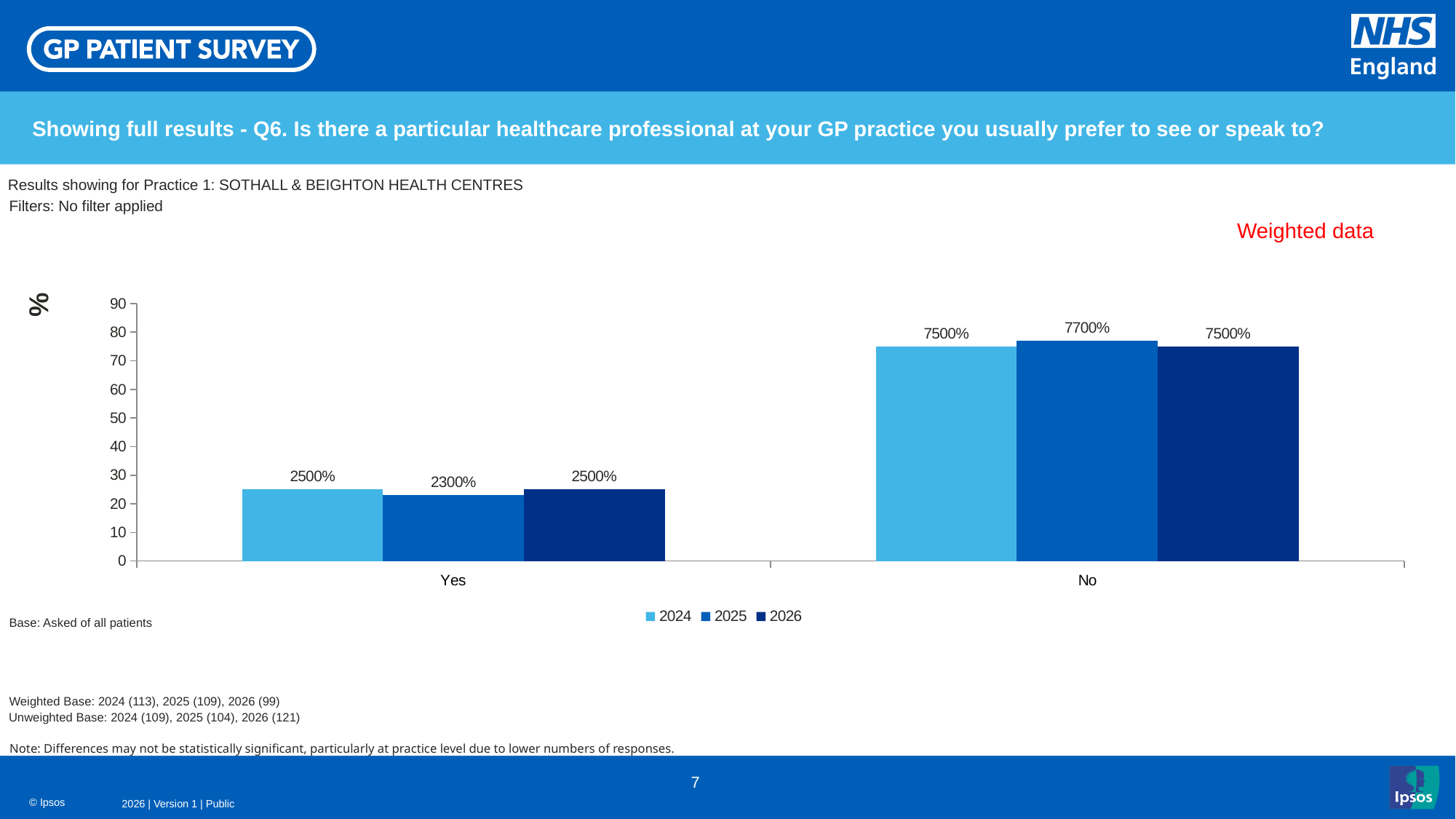
Is the 2025 bar for Yes greater or less than 30 on the axis? less Which year has the highest bar in the No category? 2025 Is the 2024 bar for No greater or less than 70 on the axis? greater What is the data label for 2024 in the Yes category? 2500% Which is larger: the 2026 bar for Yes or the 2026 bar for No? No What is the data label for 2025 in the Yes category? 2300% How many categories are shown on the x axis? 2 What is the data label for 2026 in the No category? 7500% What type of chart is shown on the slide? Bar chart How many series does the legend list? 3 What is the data label for 2025 in the No category? 7700% Which year has the lowest bar in the Yes category? 2025